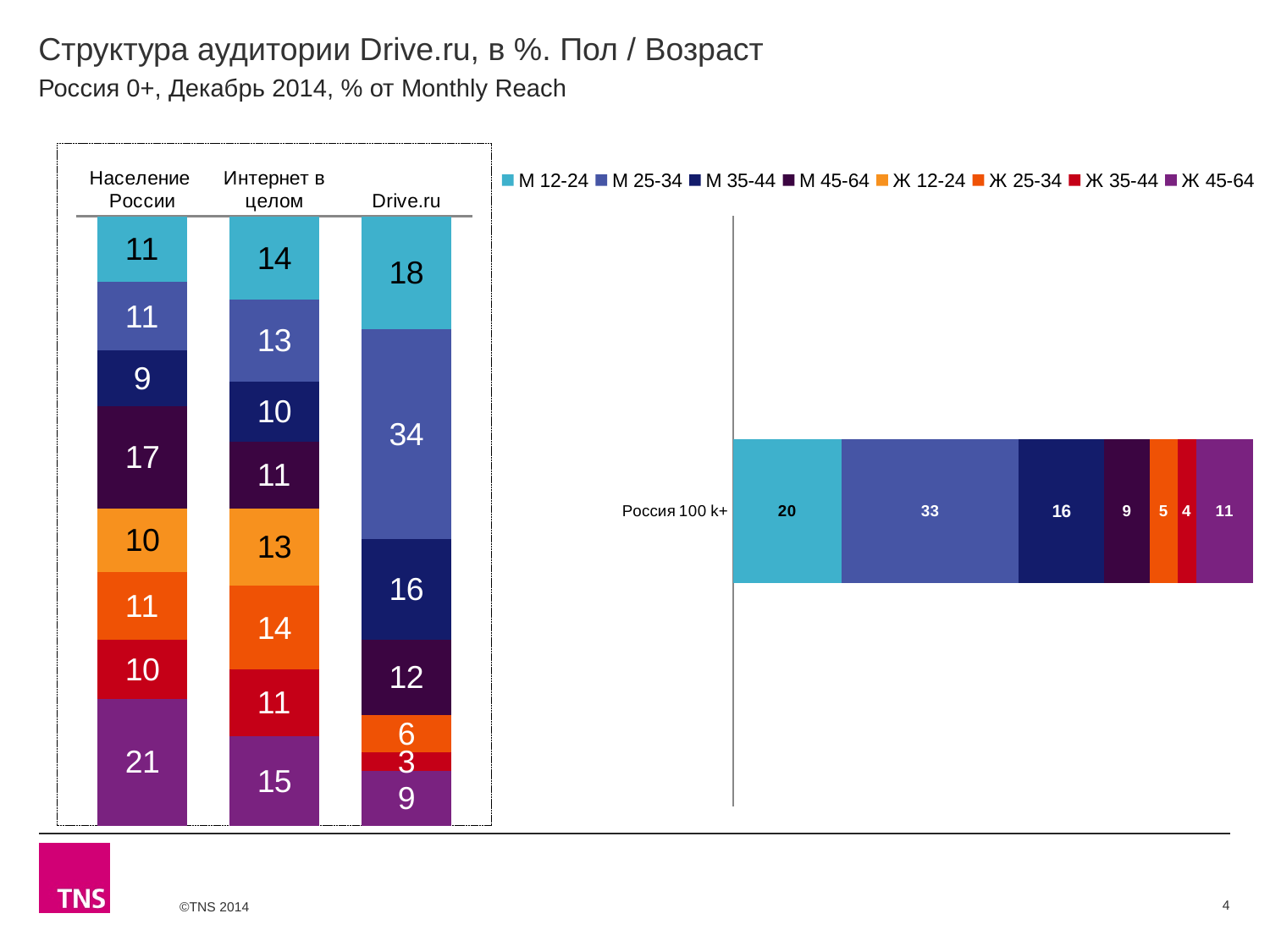
In the right chart (Россия 100 k+), what is the value of the М 25-34 segment? 33 How many categories (bars) are shown in the left chart? 3 In the right chart (Россия 100 k+), what is the value of the М 35-44 segment? 16 What type of chart is the right chart (Россия 100 k+)? Stacked bar chart In the left chart, what is the value of the М 25-34 segment for Drive.ru? 34 How many series does the legend list? 8 In the right chart (Россия 100 k+), which segment has the largest value? М 25-34 In the left chart, what is the value of the Ж 45-64 segment for Население России? 21 In the left chart, how much larger is the М 12-24 value for Drive.ru than for Население России? 7 In the left chart, which has the larger М 35-44 value: Drive.ru or Интернет в целом? Drive.ru In the right chart (Россия 100 k+), which labeled segment has the smallest value? Ж 35-44 In the left chart, what is the value of the М 12-24 segment for Интернет в целом? 14